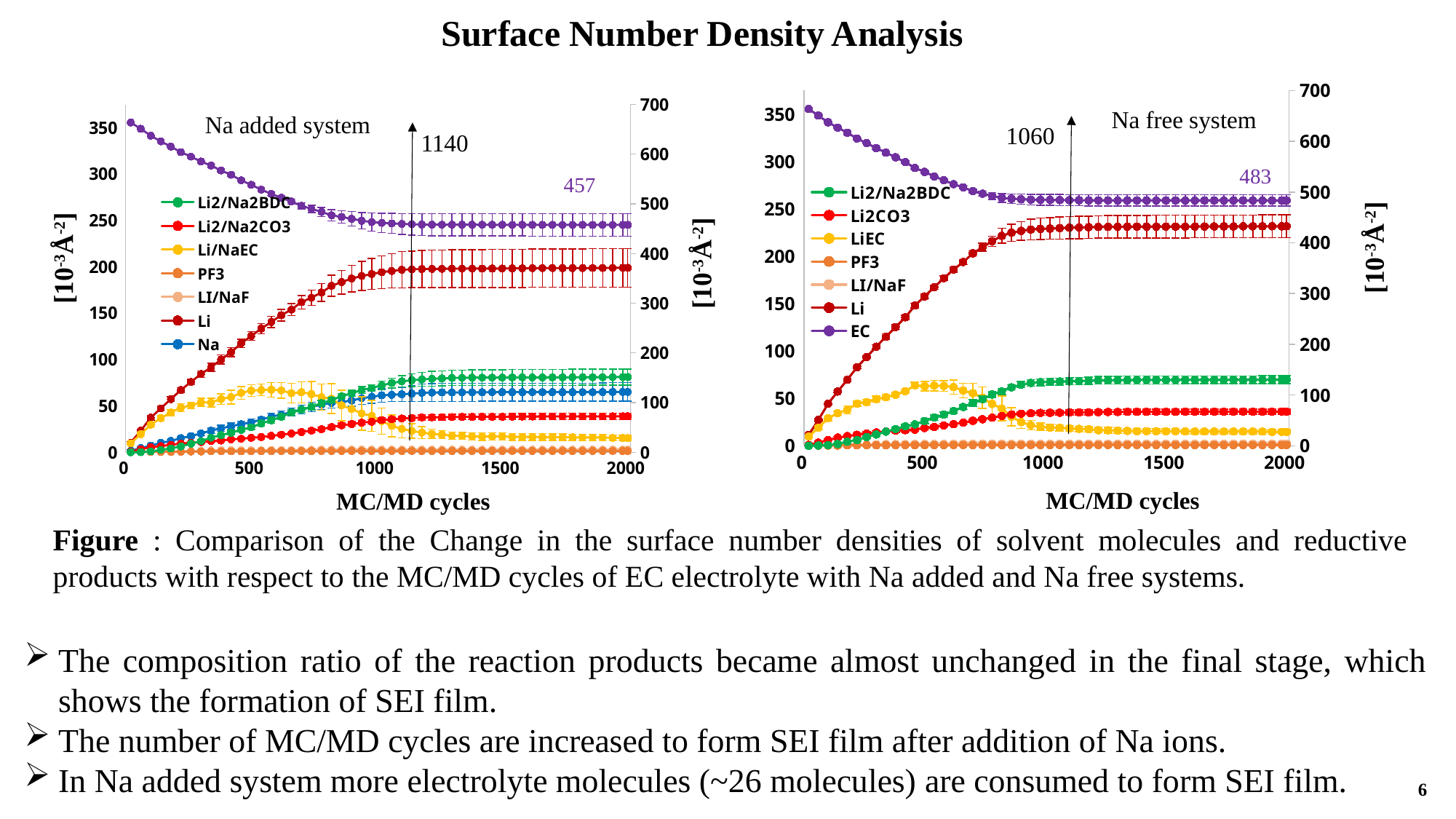
Which chart has the larger cycle number printed at its vertical arrow, the Na added system or the Na free system? Na added system What kind of chart is used for the Na added system? line chart In the Na free system chart, what cycle number is printed next to the vertical arrow? 1060 In the Na added system chart, what value is printed in purple near the end of the top curve? 457 How many series does the legend of the Na free system chart list? 7 What is the x-axis title of the Na free system chart? MC/MD cycles What is the difference between the purple values printed on the Na free system chart (483) and the Na added system chart (457)? 26 How many series does the legend of the Na added system chart list? 7 In the Na free system chart, does the EC curve rise or fall as the MC/MD cycles increase? fall In the Na free system chart, what value is printed in purple near the end of the top curve? 483 In the Na added system chart, what cycle number is printed next to the vertical arrow? 1140 What is the difference between the arrow cycle numbers printed on the Na added system chart (1140) and the Na free system chart (1060)? 80